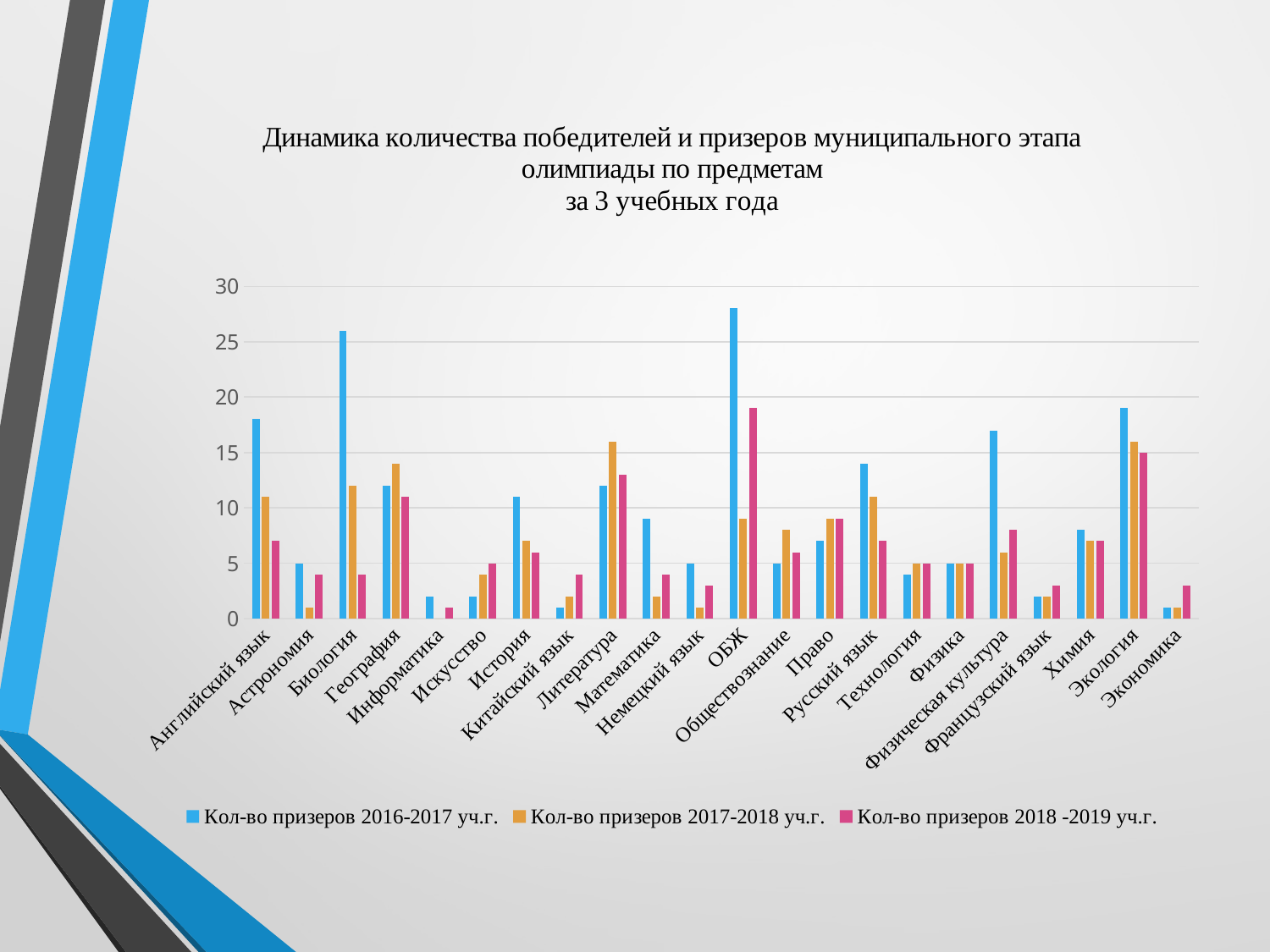
Which subject has the highest value for Кол-во призеров 2016-2017 уч.г.? ОБЖ What kind of chart is shown on the slide? bar chart Is the value for Экология in Кол-во призеров 2016-2017 уч.г. greater or less than 15? greater What colour are the bars for Кол-во призеров 2018 -2019 уч.г.? pink Is the value for Литература in Кол-во призеров 2017-2018 уч.г. greater or less than 10? greater Which subject has the highest value for Кол-во призеров 2018 -2019 уч.г.? ОБЖ For Биология, which is larger: Кол-во призеров 2016-2017 уч.г. or Кол-во призеров 2018 -2019 уч.г.? Кол-во призеров 2016-2017 уч.г. Is the value for Информатика in Кол-во призеров 2016-2017 уч.г. greater or less than 5? less For Английский язык, which is larger: Кол-во призеров 2016-2017 уч.г. or Кол-во призеров 2017-2018 уч.г.? Кол-во призеров 2016-2017 уч.г. How many subject categories are shown on the x axis? 22 How many series does the legend list? 3